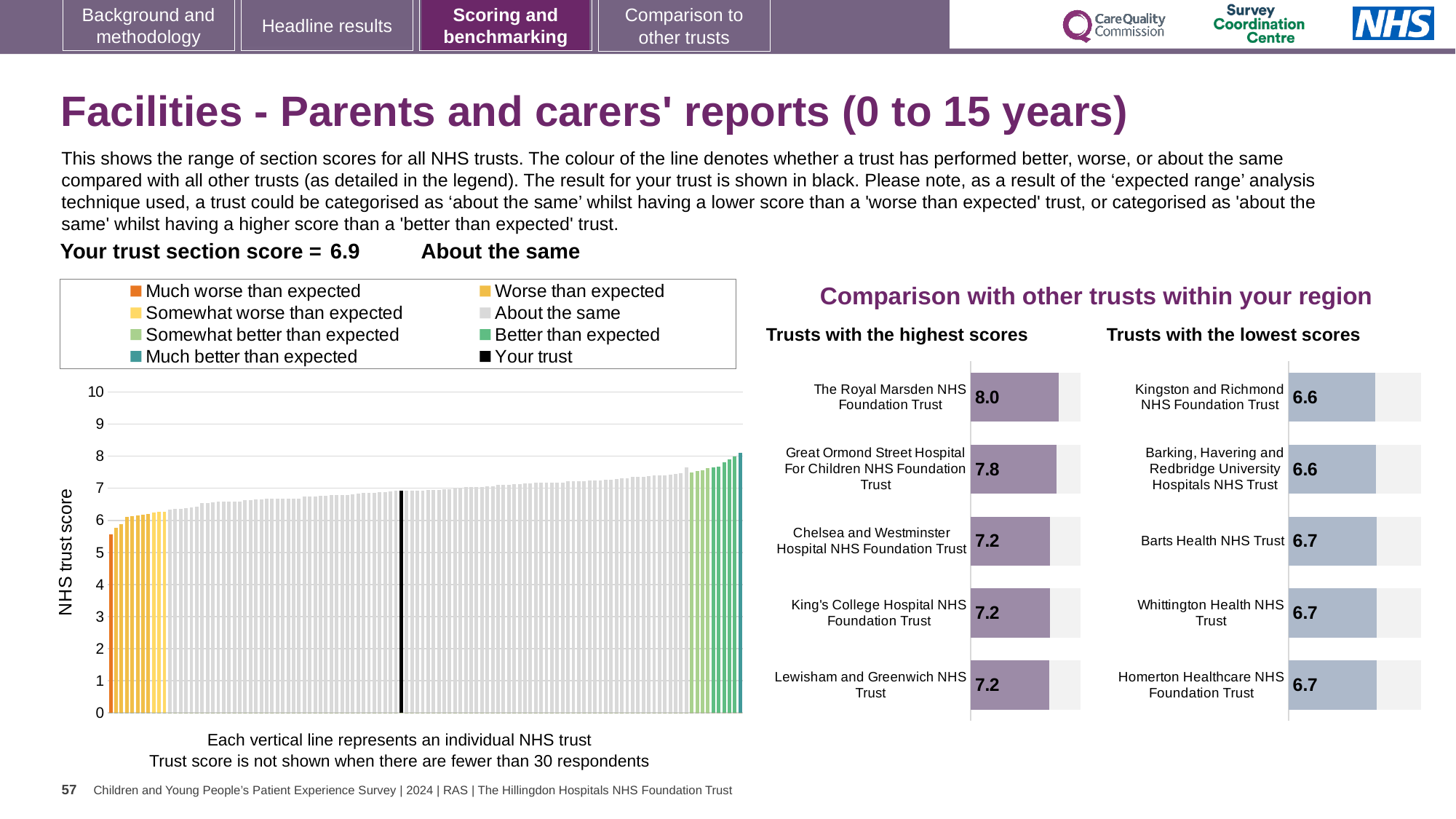
In the 'Trusts with the highest scores' chart, what is the score for The Royal Marsden NHS Foundation Trust? 8.0 In the 'Trusts with the highest scores' chart, which is larger: the score for Great Ormond Street Hospital For Children NHS Foundation Trust or the score for Chelsea and Westminster Hospital NHS Foundation Trust? Great Ormond Street Hospital For Children NHS Foundation Trust What kind of chart is the 'Trusts with the highest scores' chart? Bar chart In the 'Trusts with the highest scores' chart, what is the score for Great Ormond Street Hospital For Children NHS Foundation Trust? 7.8 In the main 'NHS trust score' chart on the left, is the value for the black 'Your trust' line greater or less than 7? less How many entries does the legend of the main 'NHS trust score' chart list? 8 In the 'Trusts with the lowest scores' chart, what is the score for Kingston and Richmond NHS Foundation Trust? 6.6 In the 'Trusts with the lowest scores' chart, what is the score for Barts Health NHS Trust? 6.7 In the 'Trusts with the highest scores' chart, what is the difference between the scores of The Royal Marsden NHS Foundation Trust and Great Ormond Street Hospital For Children NHS Foundation Trust? 0.2 In the main 'NHS trust score' chart on the left, is the value of the lowest (leftmost) bar greater or less than 5? greater How many trusts are shown in the 'Trusts with the lowest scores' chart? 5 In the 'Trusts with the highest scores' chart, which trust has the highest score? The Royal Marsden NHS Foundation Trust